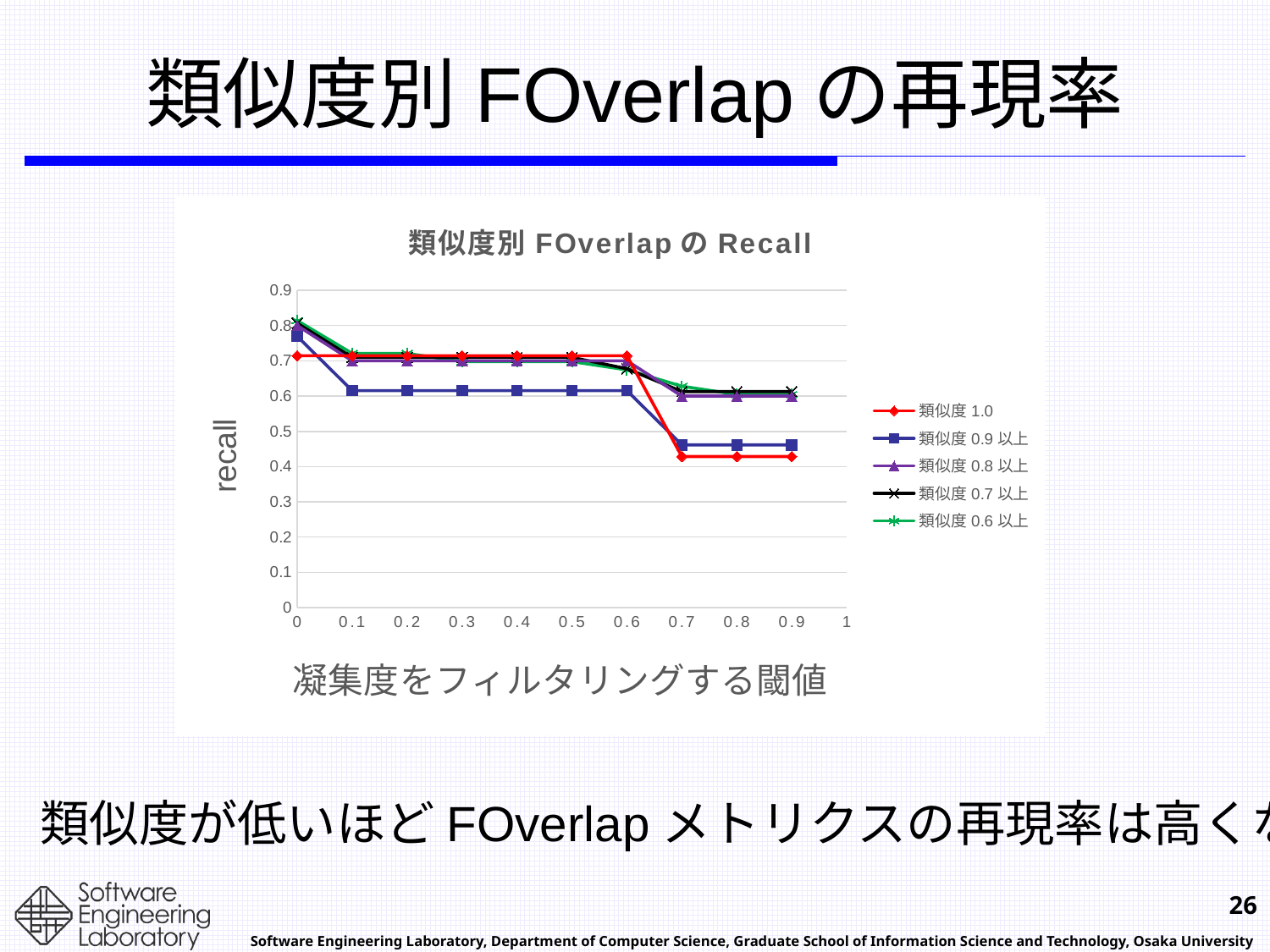
Is the value for 類似度 0.6 以上 at x = 0 greater or less than 0.7? greater What is the label of the y axis? recall Is the value for 類似度 0.9 以上 at x = 0.8 greater or less than 0.5? less At x = 0.3, which is larger: 類似度 1.0 or 類似度 0.9 以上? 類似度 1.0 At x = 0.9, which is larger: 類似度 1.0 or 類似度 0.7 以上? 類似度 0.7 以上 Is the value for 類似度 0.7 以上 at x = 0.9 greater or less than 0.5? greater How many data points are plotted for the 類似度 1.0 series? 10 What kind of chart is shown on the slide? line chart How many series does the legend list? 5 Which series has the lowest value at x = 0.9? 類似度 1.0 What is the title of the chart? 類似度別 FOverlap の Recall